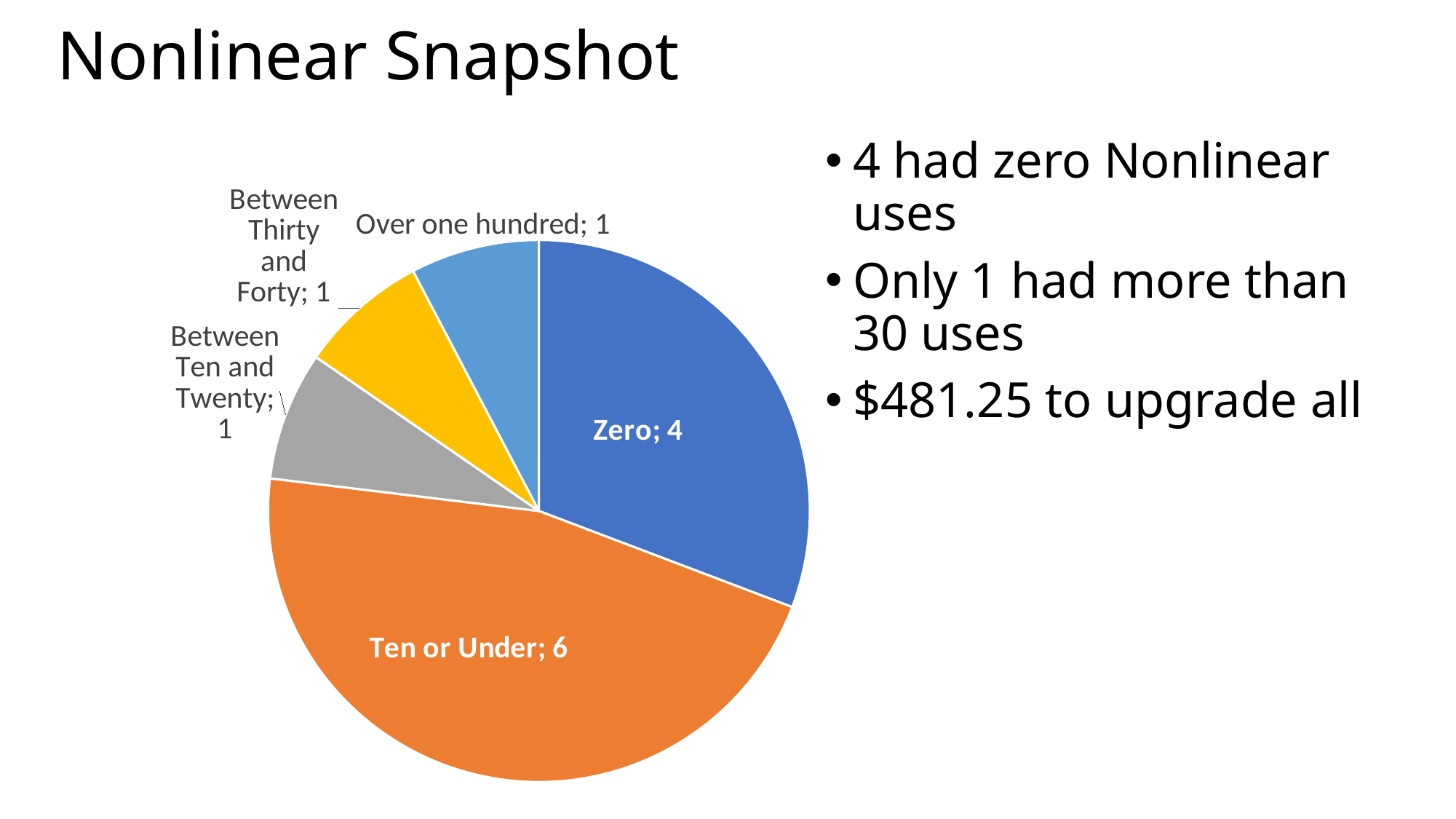
What is the total of all the slice values in the pie chart? 13 What is the difference between the Zero value and the Over one hundred value? 3 How many slices does the pie chart have? 5 What is the value for the Zero slice? 4 What is the value for the Ten or Under slice? 6 What kind of chart is shown on the slide? pie chart What colour is the Ten or Under slice? orange Which category has the largest slice of the pie? Ten or Under Which is larger, the value for Zero or the value for Between Ten and Twenty? Zero What is the value for the Over one hundred slice? 1 What is the difference between the Ten or Under value and the Zero value? 2 What is the value for the Between Thirty and Forty slice? 1